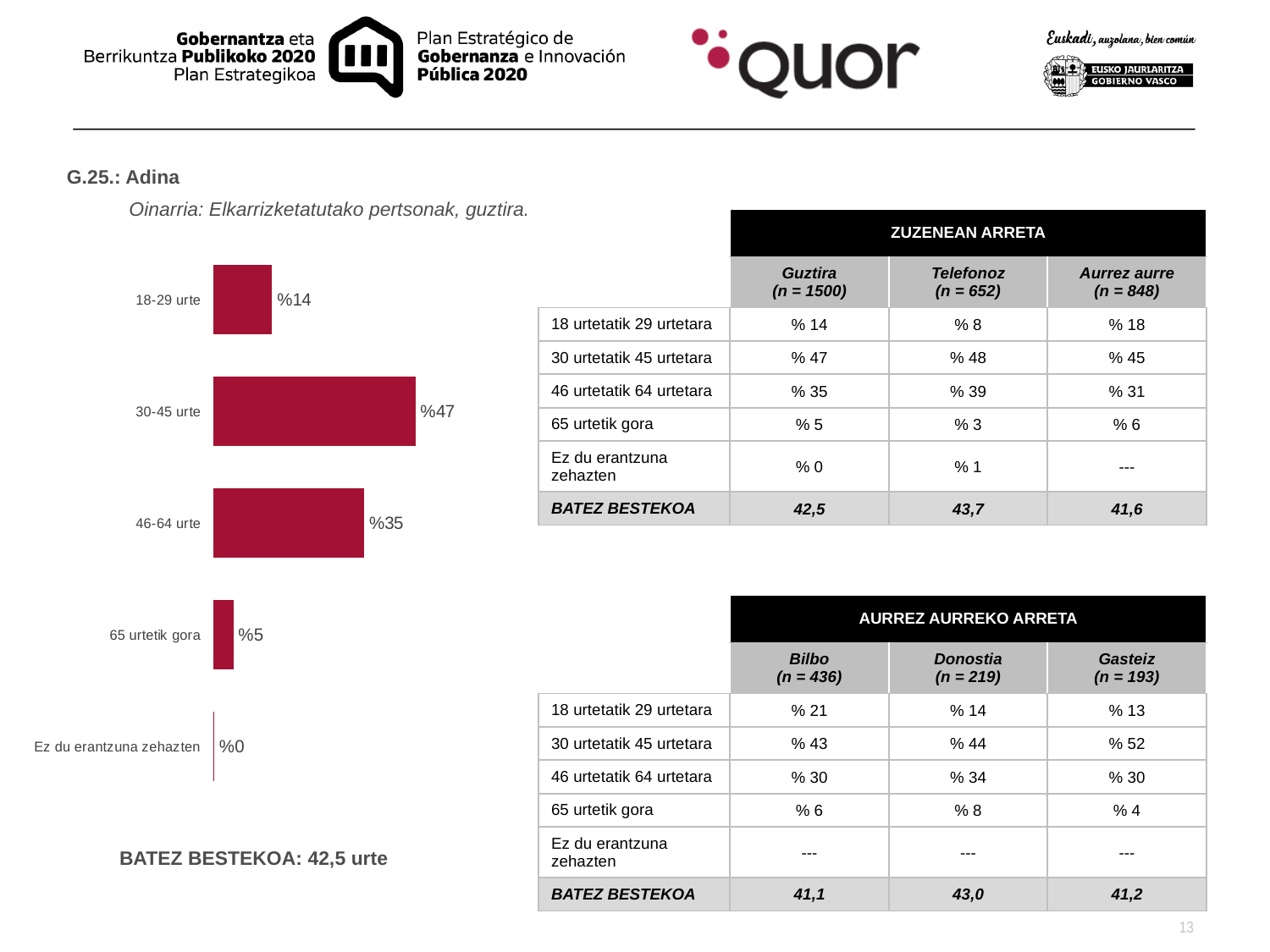
Which is larger in the bar chart, the value for 46-64 urte or the value for 18-29 urte? 46-64 urte Which category has the lowest value in the bar chart? Ez du erantzuna zehazten Which category has the highest value in the bar chart? 30-45 urte What is the value for the 46-64 urte category in the bar chart? %35 What kind of chart is shown on the slide? Bar chart What is the difference between the values for 30-45 urte and 46-64 urte in the bar chart? %12 What is the value for the 30-45 urte category in the bar chart? %47 What is the title of the chart on the slide? G.25.: Adina What is the value for the 18-29 urte category in the bar chart? %14 What is the difference between the values for 18-29 urte and 65 urtetik gora in the bar chart? %9 What is the value for the 65 urtetik gora category in the bar chart? %5 How many categories are shown in the bar chart? 5